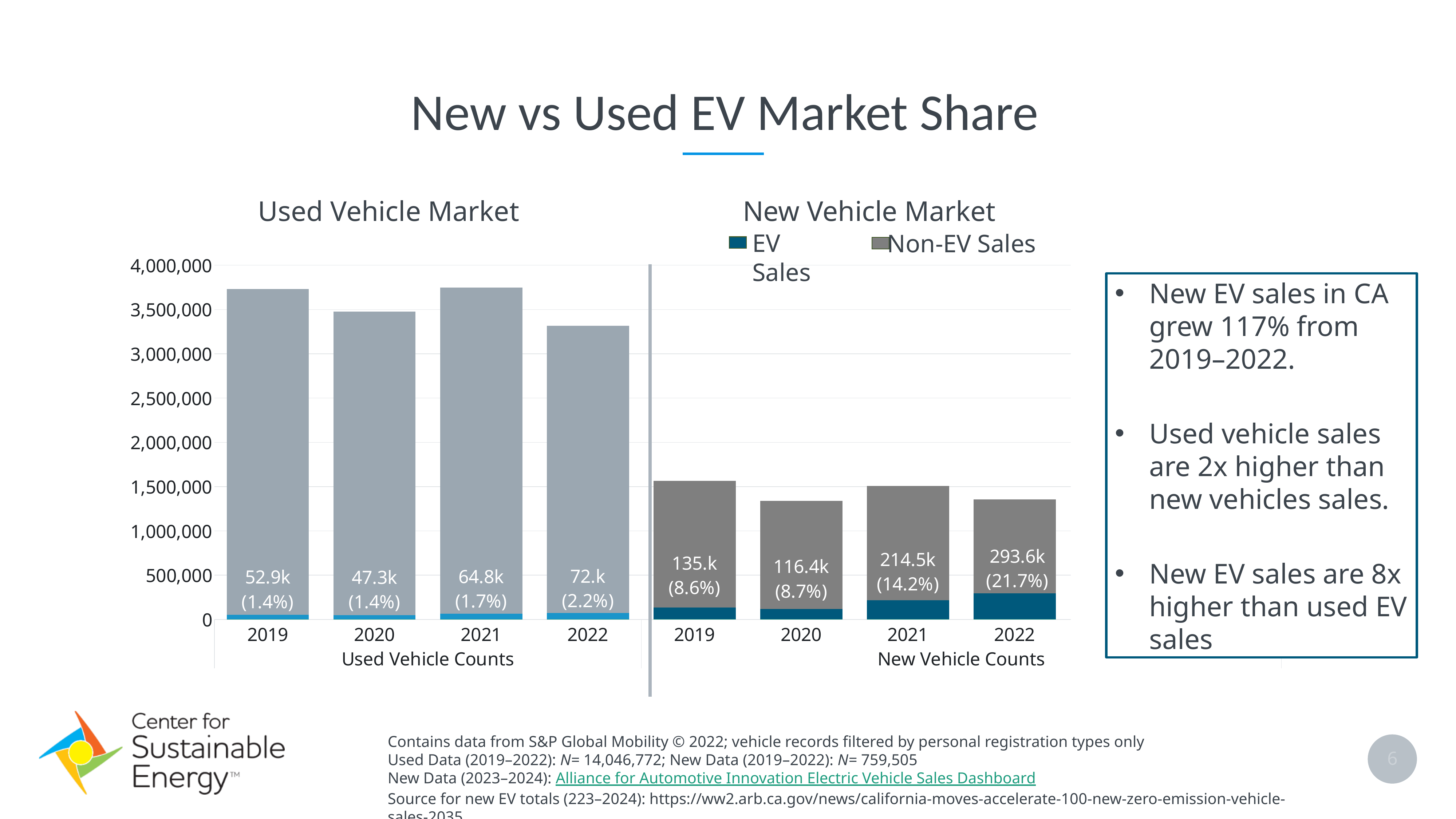
In the Used Vehicle Market chart, which year has the larger labelled EV count, 2020 or 2021? 2021 In the New Vehicle Market chart, which year has the highest labelled EV sales? 2022 What type of chart is the New Vehicle Market chart? Bar chart How many series does the legend of the New Vehicle Market chart list? 2 In the New Vehicle Market chart, what EV share percentage is shown for 2022? 21.7% In the Used Vehicle Market chart, which year has the lowest labelled EV count? 2020 In the New Vehicle Market chart, is the total bar for 2020 greater or less than 1,500,000? less In the New Vehicle Market chart, what is the EV sales value labelled for 2021? 214.5k In the Used Vehicle Market chart, what EV share percentage is shown for 2021? 1.7% How many years are shown on the x axis of the Used Vehicle Market chart? 4 In the Used Vehicle Market chart, is the total bar for 2022 greater or less than 3,000,000? greater In the New Vehicle Market chart, what is the difference between the labelled EV sales for 2022 and 2019? 158.6k